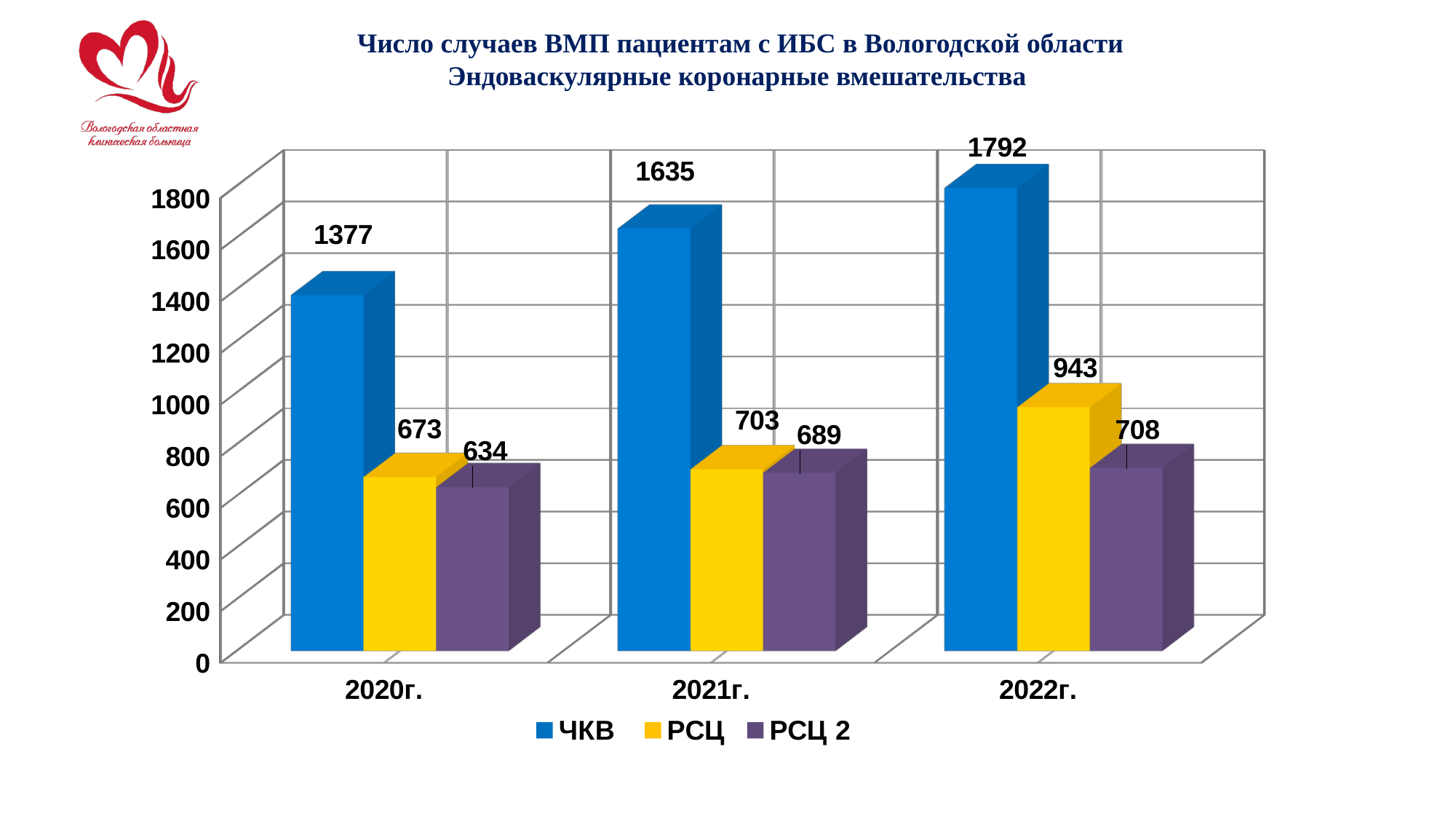
In which year is the РСЦ 2 value lowest? 2020г. What kind of chart is shown on the slide? bar chart In which year is the ЧКВ value highest? 2022г. What is the value for РСЦ 2 in 2021г.? 689 What is the difference between the ЧКВ values for 2022г. and 2021г.? 157 How many series does the legend list? 3 Is the value for ЧКВ in 2021г. greater or less than 1600? greater What is the value for РСЦ in 2022г.? 943 Which is larger in 2021г., РСЦ or РСЦ 2? РСЦ Do the ЧКВ values rise or fall from 2020г. to 2022г.? rise How many years are shown on the x axis? 3 What is the value for ЧКВ in 2020г.? 1377